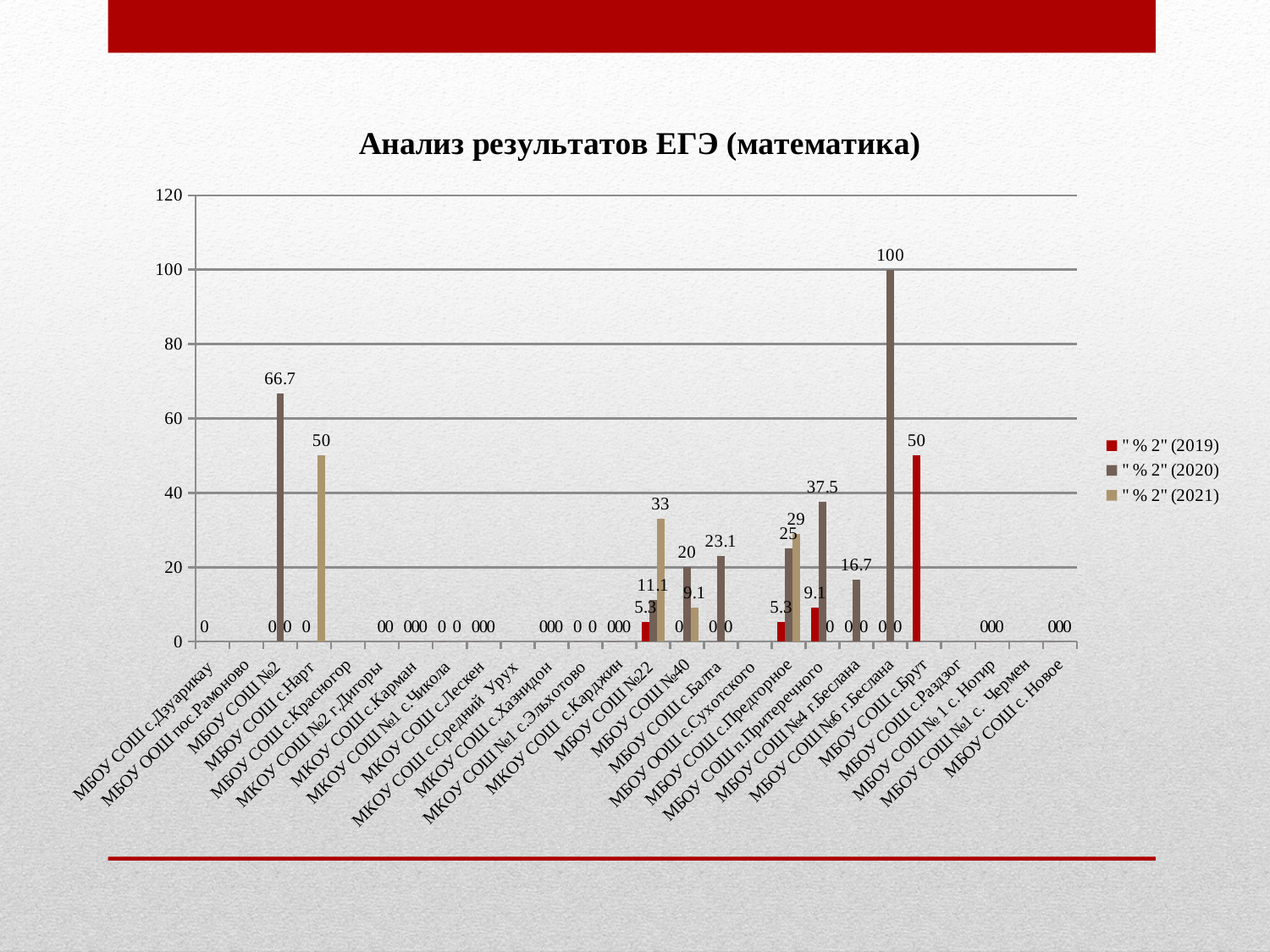
What is the " % 2" (2020) value for МБОУ СОШ №6 г.Беслана? 100 Which has the larger " % 2" (2020) value, МБОУ СОШ с.Балта or МБОУ СОШ №40? МБОУ СОШ с.Балта How many schools are listed on the x axis? 26 What is the " % 2" (2020) value for МБОУ СОШ №4 г.Беслана? 16.7 What is the " % 2" (2019) value for МБОУ СОШ с.Брут? 50 What is the " % 2" (2021) value for МБОУ СОШ №22? 33 What is the difference between the " % 2" (2020) values for МБОУ СОШ п.Притеречного and МБОУ СОШ с.Предгорное? 12.5 How many series does the legend list? 3 What kind of chart is shown on the slide? bar chart What is the title of the chart? Анализ результатов ЕГЭ (математика) Which school has the highest " % 2" (2020) value? МБОУ СОШ №6 г.Беслана What is the " % 2" (2020) value for МБОУ СОШ №2? 66.7